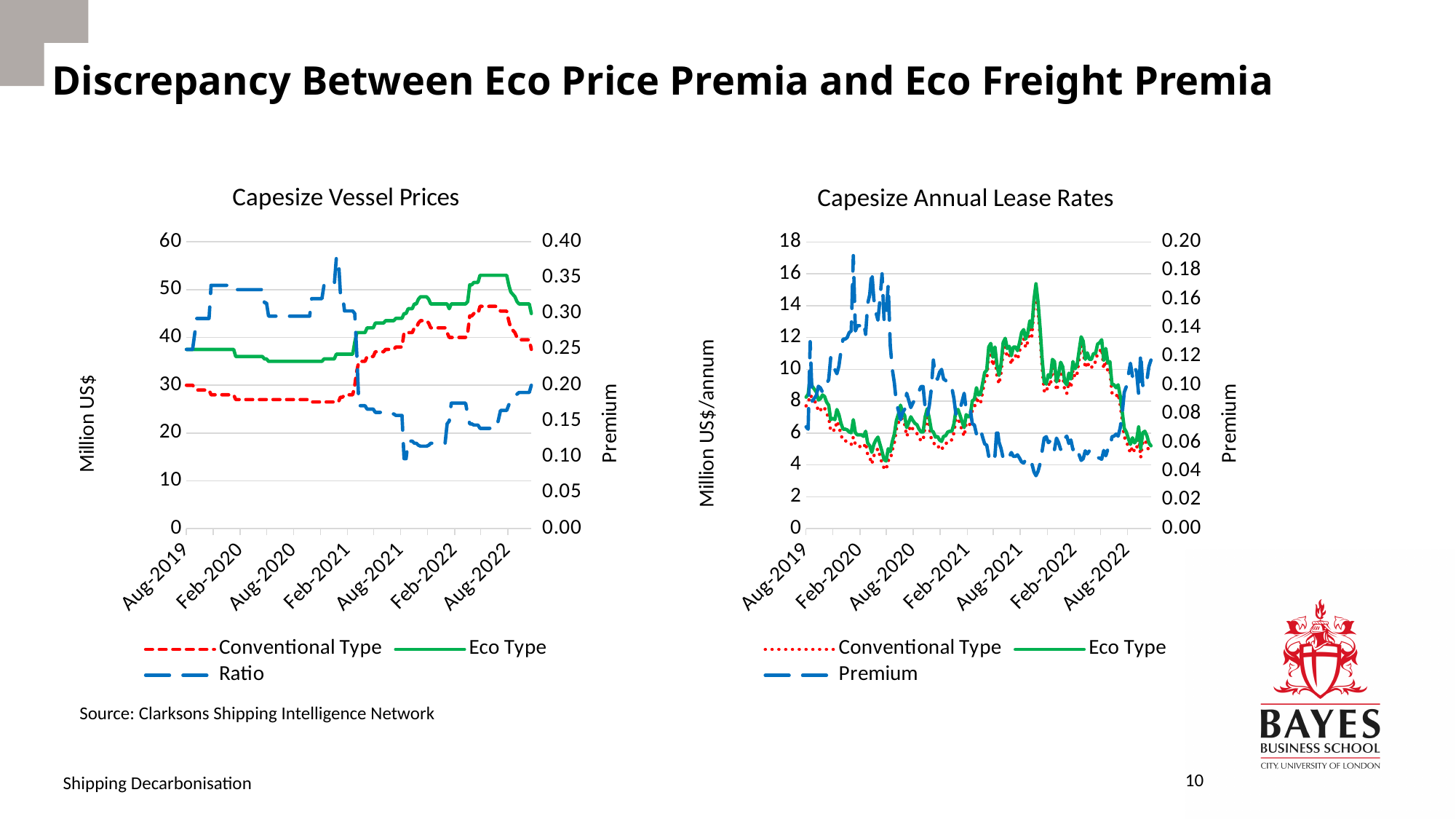
In the 'Capesize Annual Lease Rates' chart, is the peak value of the Eco Type line greater or less than 14? greater In the 'Capesize Vessel Prices' chart, is the peak value of the Eco Type line greater or less than 50? greater What kind of chart is the 'Capesize Vessel Prices' chart? line chart How many series does the legend of the 'Capesize Annual Lease Rates' chart list? 3 In the 'Capesize Annual Lease Rates' chart, does the Premium line overall rise or fall from Feb-2020 to Feb-2022? fall In the 'Capesize Vessel Prices' chart, which series is higher at Aug-2022, Eco Type or Conventional Type? Eco Type In the 'Capesize Vessel Prices' chart, is the Eco Type value at Aug-2019 greater or less than 40? less What is the label of the right-hand vertical axis of the 'Capesize Annual Lease Rates' chart? Premium In the 'Capesize Vessel Prices' chart, which series does the legend list alongside Conventional Type and Eco Type? Ratio In the 'Capesize Vessel Prices' chart, does the Eco Type line overall rise or fall from Aug-2019 to Aug-2022? rise